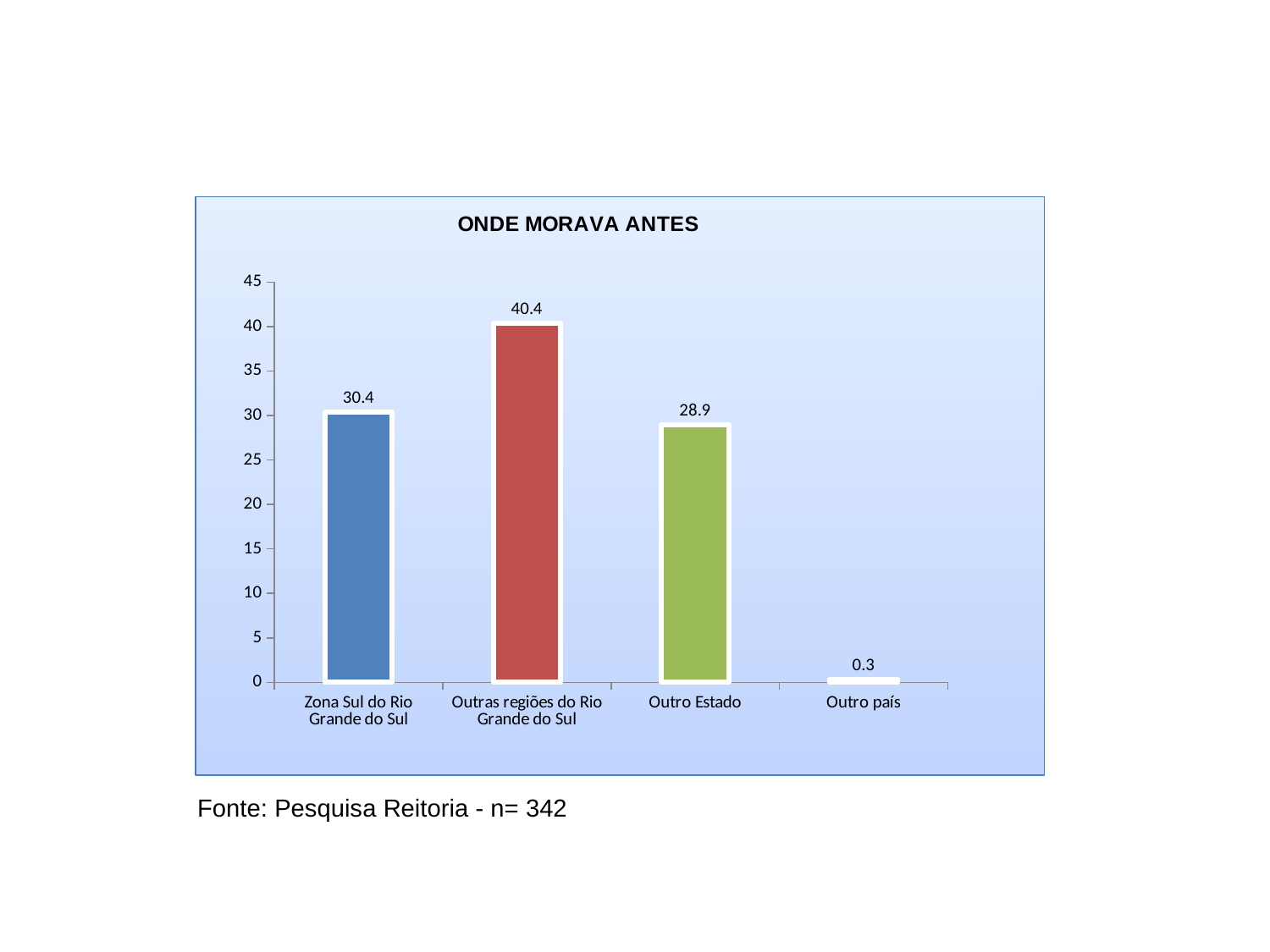
Which category has the lowest value? Outro país What is the difference between the values for Outras regiões do Rio Grande do Sul and Zona Sul do Rio Grande do Sul? 10.0 What is the value for Outras regiões do Rio Grande do Sul? 40.4 What is the value for Zona Sul do Rio Grande do Sul? 30.4 What kind of chart is shown on the slide? Bar chart Which category has the highest value? Outras regiões do Rio Grande do Sul What is the title of the chart? ONDE MORAVA ANTES What is the difference between the values for Zona Sul do Rio Grande do Sul and Outro Estado? 1.5 How many categories are shown on the chart? 4 Which is larger, the value for Zona Sul do Rio Grande do Sul or the value for Outro Estado? Zona Sul do Rio Grande do Sul What is the value for Outro Estado? 28.9 What is the value for Outro país? 0.3